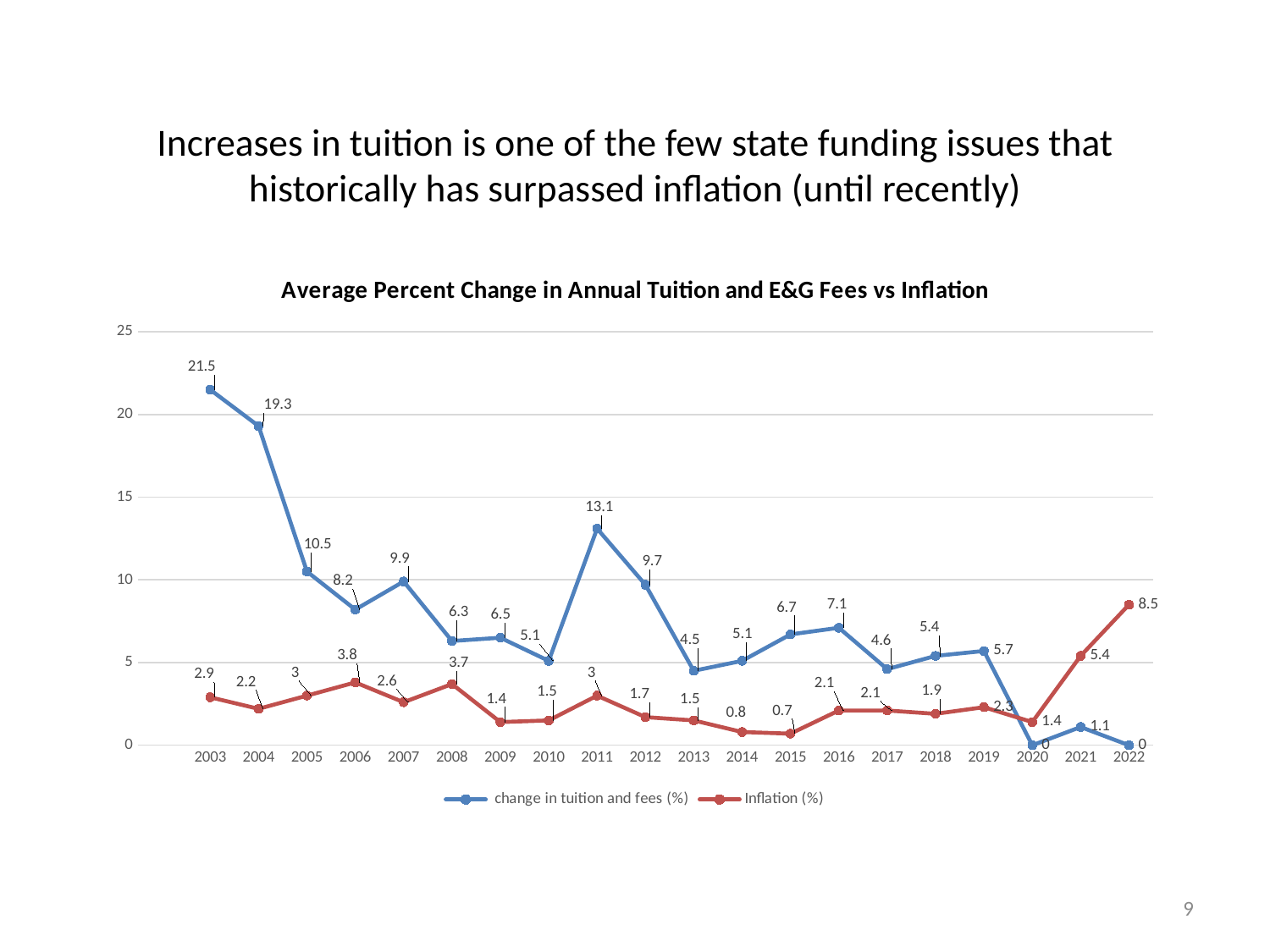
In which year is the change in tuition and fees (%) at its highest? 2003 What is the difference between the change in tuition and fees (%) and Inflation (%) in 2003? 18.6 What is the title of the chart? Average Percent Change in Annual Tuition and E&G Fees vs Inflation What is the change in tuition and fees (%) for 2011? 13.1 What is the change in tuition and fees (%) for 2003? 21.5 How many years are plotted on the x axis? 20 How many series does the legend list? 2 In which year is the Inflation (%) series at its highest? 2022 In 2022, which is larger: the change in tuition and fees (%) or Inflation (%)? Inflation (%) In which year is the Inflation (%) series at its lowest? 2015 What kind of chart is shown on the slide? Line chart What is the Inflation (%) value for 2022? 8.5